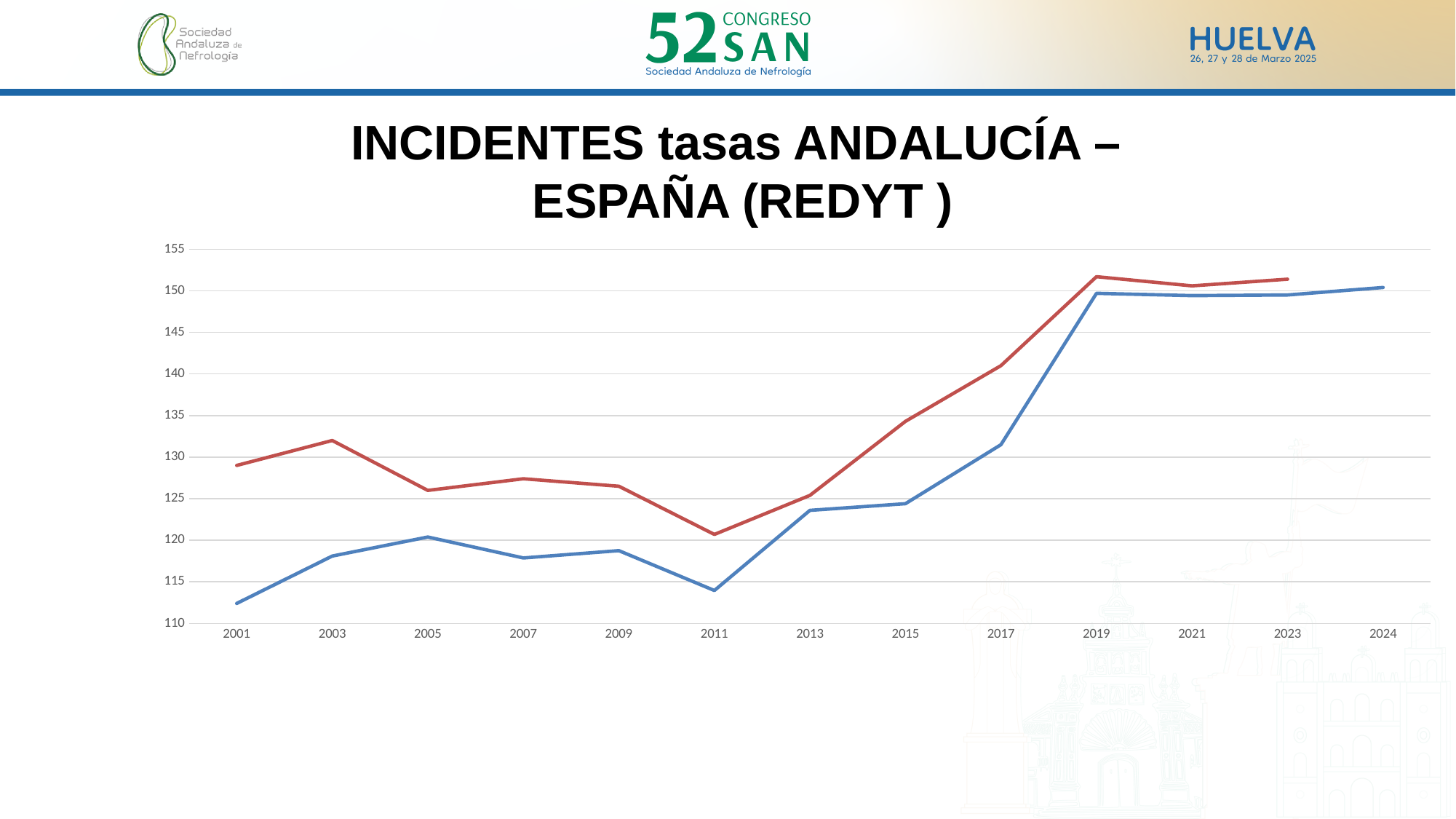
In which year does the red line reach its lowest value? 2011 What kind of chart is shown on the slide? line chart Is the value of the blue line in 2017 greater or less than 130? greater In which year does the blue line have its lowest value? 2001 Does the blue line rise or fall between 2011 and 2019? rise Is the value of the blue line in 2011 greater or less than 120? less Is the value of the red line in 2011 greater or less than 125? less How many year labels are shown on the x axis of the chart? 13 In 2003, which line has the higher value, the red line or the blue line? red line What is the title of the chart on the slide? INCIDENTES tasas ANDALUCÍA – ESPAÑA (REDYT )